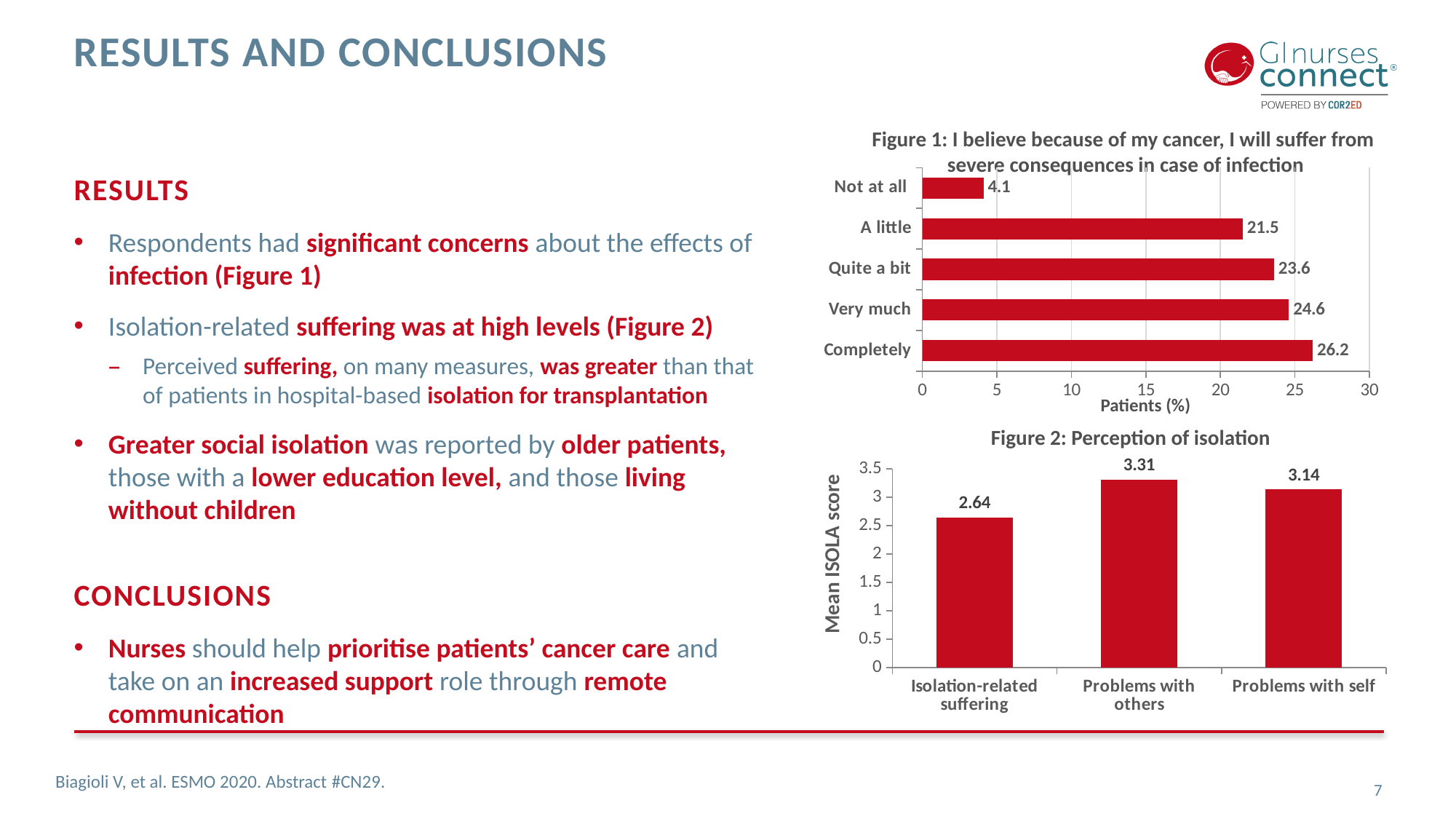
In Figure 2, which category has the lowest mean ISOLA score? Isolation-related suffering In Figure 2, which is larger: the mean ISOLA score for "Problems with others" or for "Problems with self"? Problems with others In Figure 2, what is the mean ISOLA score for "Problems with others"? 3.31 In Figure 2, what is the difference between the mean ISOLA scores for "Problems with others" and "Isolation-related suffering"? 0.67 In Figure 1, which response category has the lowest percentage of patients? Not at all What type of chart is Figure 2? Bar chart In Figure 1, is the value for "A little" greater or less than 20? greater In Figure 1, what is the difference between the percentages for "Very much" and "Quite a bit"? 1.0 In Figure 1, which response category has the highest percentage of patients? Completely In Figure 1, what percentage of patients answered "Completely"? 26.2 In Figure 1, what percentage of patients answered "Not at all"? 4.1 In Figure 1, how many response categories are shown? 5